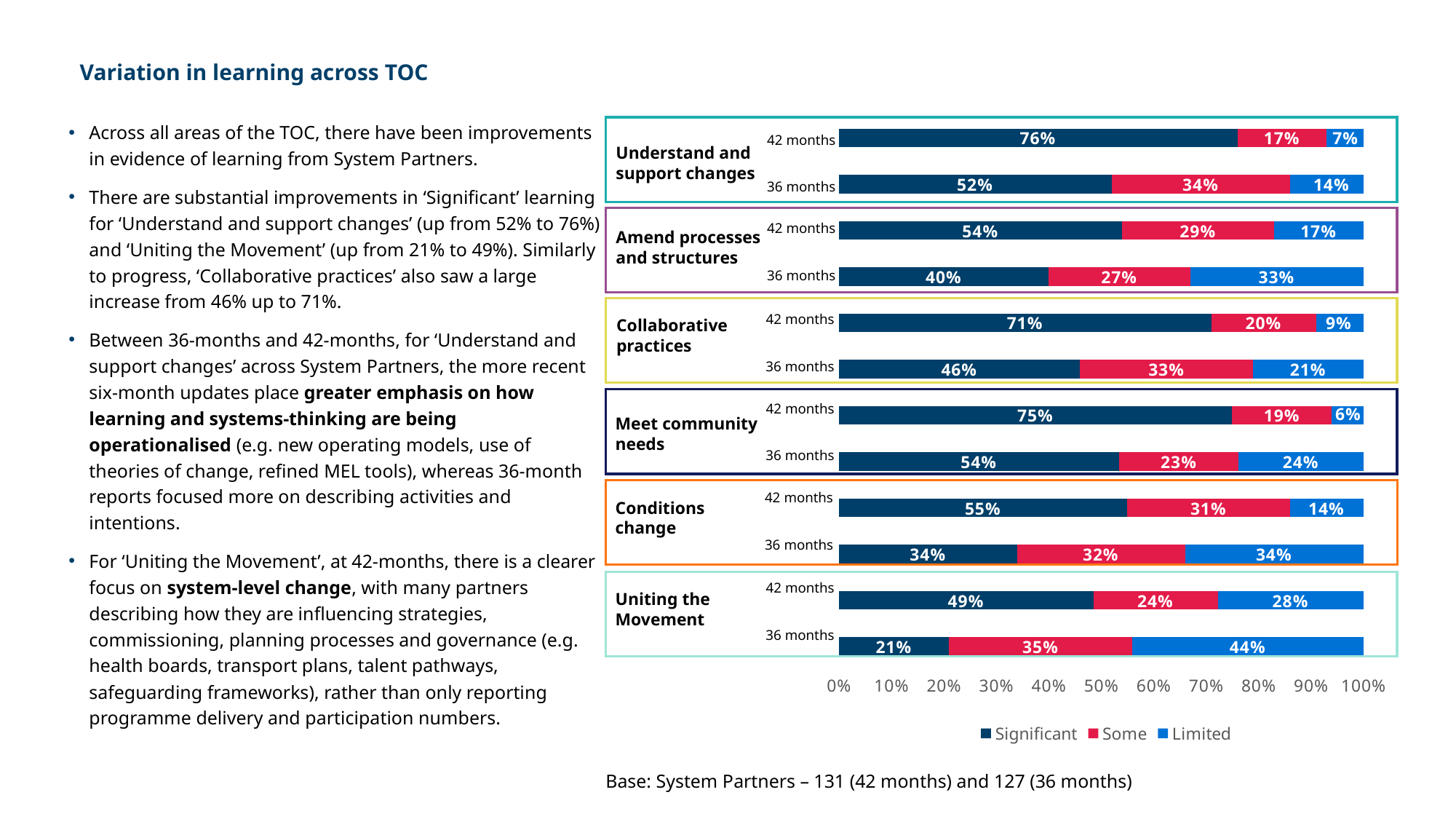
Which is larger: the 'Limited' value for 'Amend processes and structures' at 36 months or at 42 months? 36 months How many TOC areas are shown in the chart? 6 What is the total of the 'Significant' and 'Some' segments for 'Meet community needs' at 42 months? 94% What is the 'Some' value for 'Conditions change' at 42 months? 31% Which colour represents the 'Some' series in the chart? Red Which 36-month bar has the lowest 'Significant' value? Uniting the Movement What kind of chart is shown on the slide? Stacked bar chart How many series does the legend list? 3 What is the 'Limited' value for 'Uniting the Movement' at 36 months? 44% Which 42-month bar has the highest 'Significant' value? Understand and support changes What is the difference between the 'Significant' values for 'Collaborative practices' at 42 months and 36 months? 25% What is the 'Significant' value for 'Understand and support changes' at 42 months? 76%